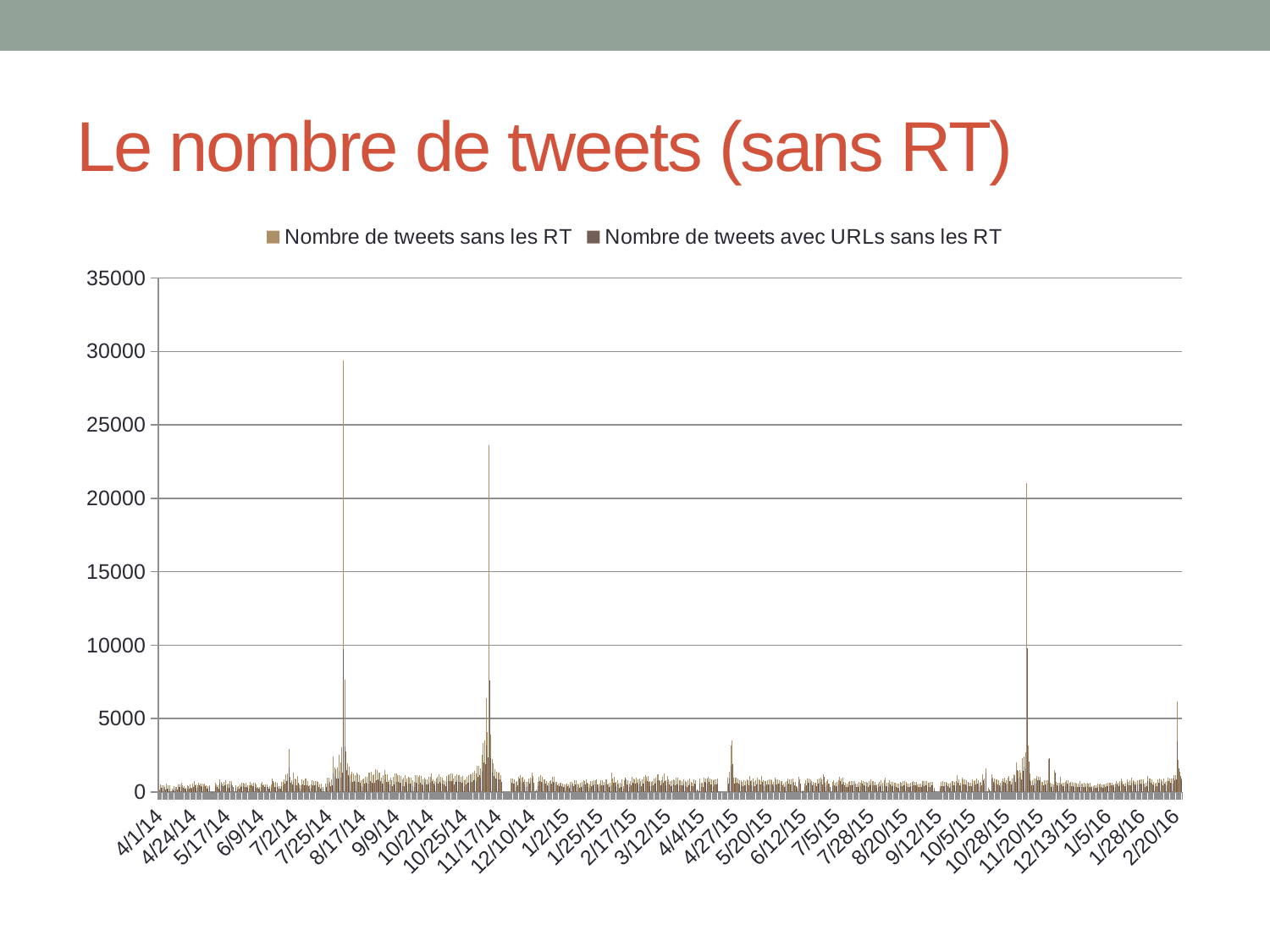
Is the spike of 'Nombre de tweets sans les RT' in November 2015 greater or less than 20000? greater Is the tallest spike of 'Nombre de tweets sans les RT' (in August 2014) greater or less than 25000? greater Is the spike of 'Nombre de tweets sans les RT' in November 2014 greater or less than 25000? less What is the highest value shown on the vertical axis of the chart? 35000 What is the first date label on the horizontal axis of the chart? 4/1/14 What is the title of the slide containing the chart? Le nombre de tweets (sans RT) What is the last date label on the horizontal axis of the chart? 2/20/16 What kind of chart is shown on the slide? bar chart What are the two series named in the chart legend? Nombre de tweets sans les RT; Nombre de tweets avec URLs sans les RT Which is larger: the spike of 'Nombre de tweets sans les RT' in August 2014 or the spike in November 2015? August 2014 How many series does the legend list? 2